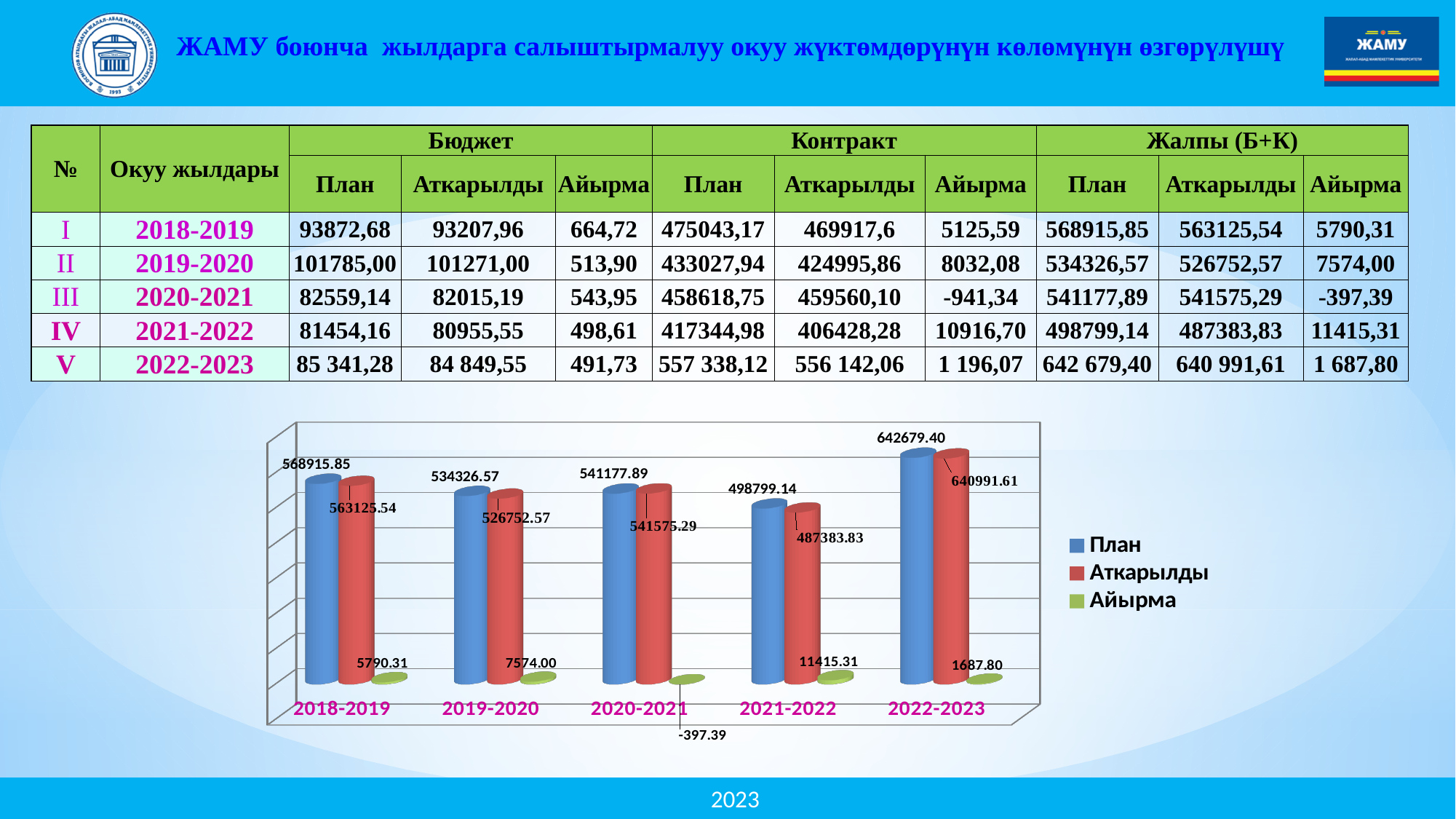
Which year has the highest Айырма value in the chart? 2021-2022 Which year has the highest План value in the chart? 2022-2023 What is the value of Аткарылды for 2021-2022 in the chart? 487383.83 Which year has the lowest Аткарылды value in the chart? 2021-2022 What is the value of Айырма for 2020-2021 in the chart? -397.39 What kind of chart is shown on the slide? Bar chart What is the value of Аткарылды for 2022-2023 in the chart? 640991.61 How many years are shown on the x axis of the chart? 5 What is the value of План for 2018-2019 in the chart? 568915.85 How many series does the chart legend list? 3 Which is larger in the chart for 2020-2021: План or Аткарылды? Аткарылды What is the difference between План and Аткарылды for 2019-2020 in the chart? 7574.00